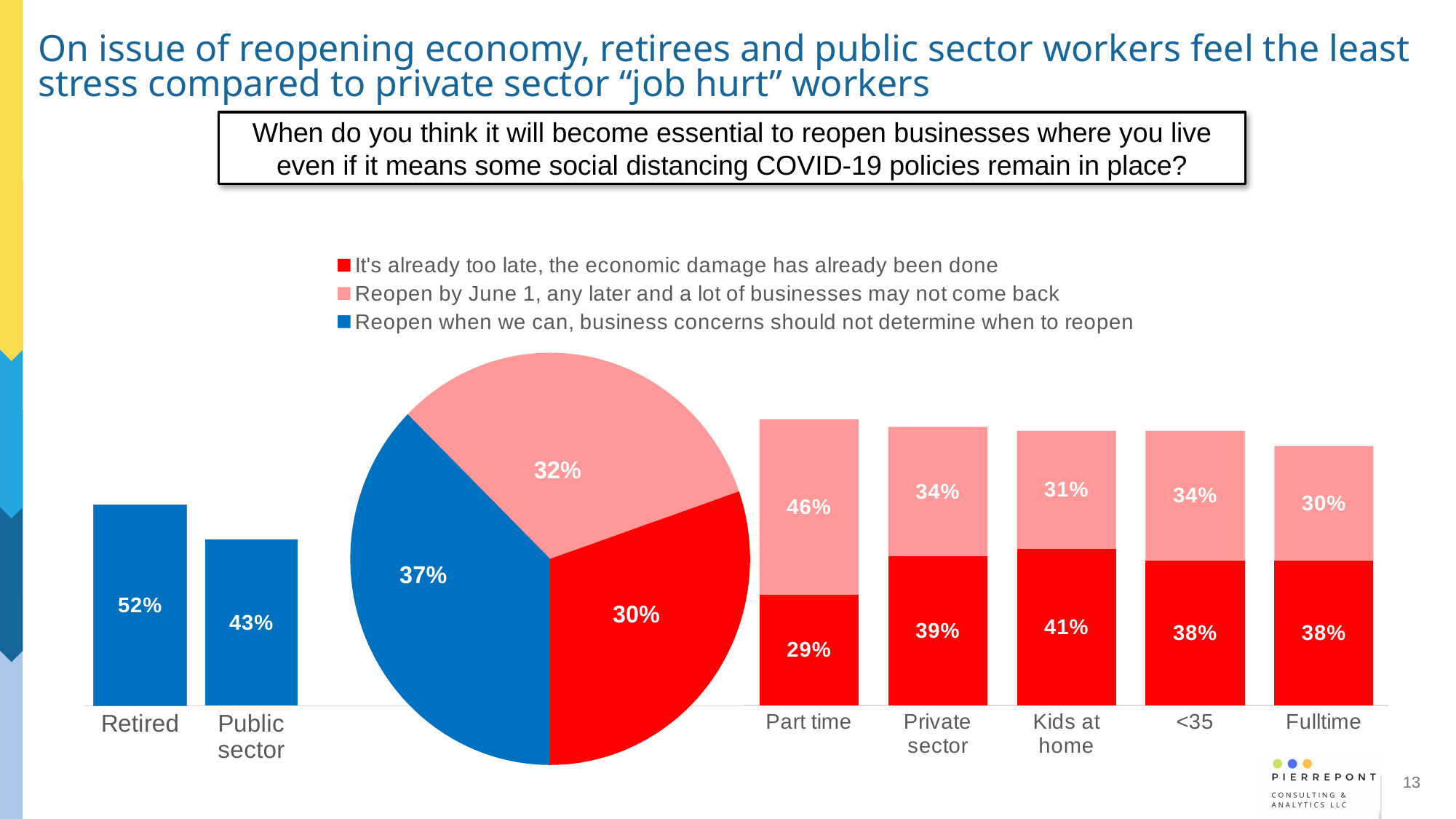
In the stacked bar chart on the right of the slide, what is the red 'It's already too late' value for Part time? 29% In the pie chart in the middle of the slide, what share is shown for 'It's already too late, the economic damage has already been done'? 30% In the pie chart in the middle of the slide, which response has the largest slice? Reopen when we can, business concerns should not determine when to reopen In the stacked bar chart on the right of the slide, which category has the highest red 'It's already too late' value? Kids at home In the bar chart on the left of the slide, what is the value for Public sector? 43% How many entries does the legend on the slide list? 3 In the bar chart on the left of the slide, what is the value for Retired? 52% In the bar chart on the left of the slide, what is the difference between the Retired and Public sector values? 9% In the stacked bar chart on the right of the slide, what is the pink 'Reopen by June 1' value for Kids at home? 31% In the pie chart in the middle of the slide, what share is shown for 'Reopen when we can, business concerns should not determine when to reopen'? 37% In the stacked bar chart on the right of the slide, what is the total of the two segments for Part time? 75% In the stacked bar chart on the right of the slide, how many categories are shown on the x axis? 5